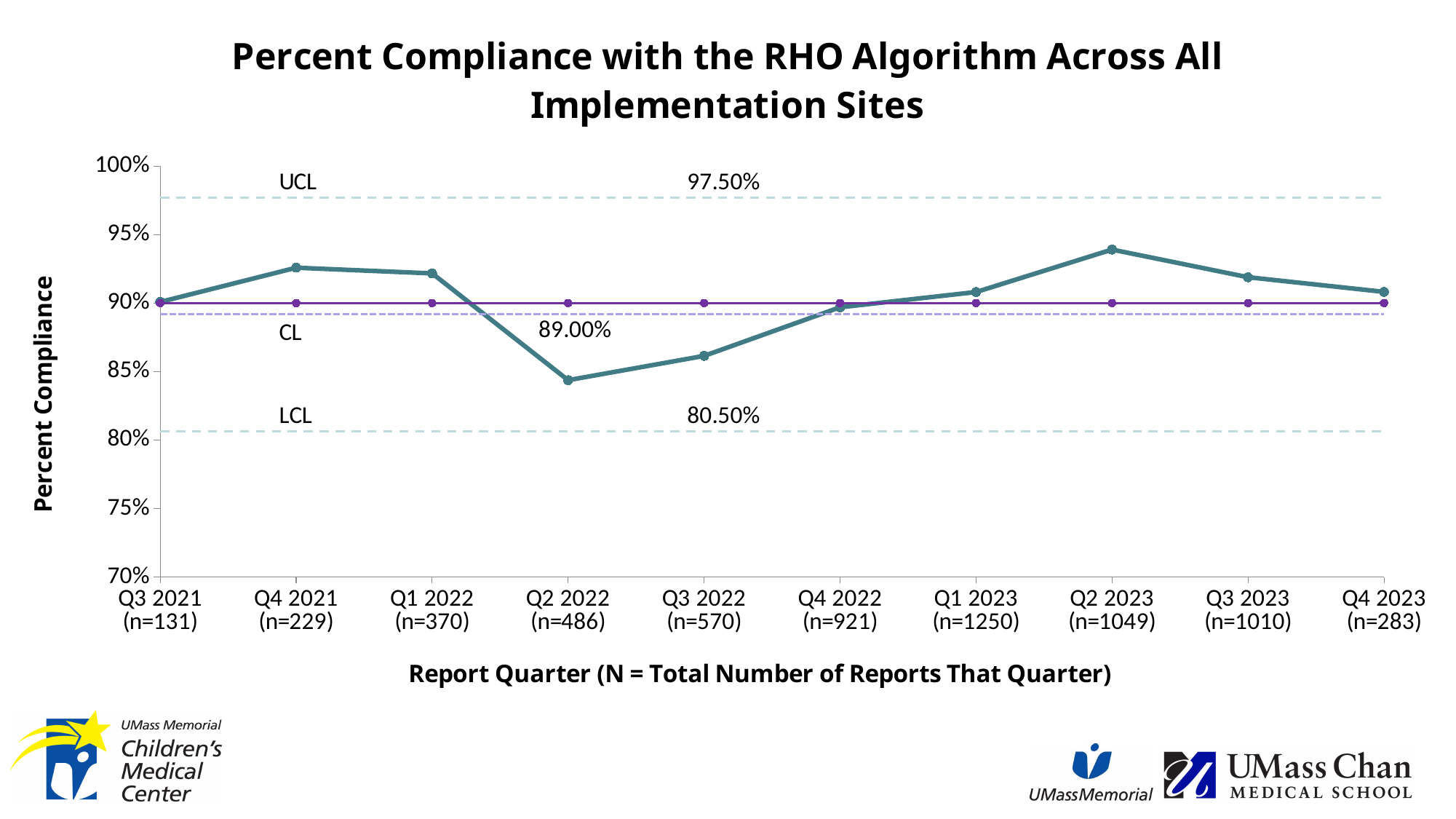
What is the value of the CL (center line) shown on the chart? 89.00% What is the value of the LCL (lower control limit) shown on the chart? 80.50% How many report quarters are plotted along the x axis? 10 What is the difference between the UCL and the LCL values printed on the chart? 17.00% Which report quarter has the highest percent compliance? Q2 2023 Which has the higher percent compliance, Q4 2021 or Q3 2022? Q4 2021 Is the percent compliance for Q2 2023 greater or less than 90%? greater Is the percent compliance for Q2 2022 greater or less than 85%? less Which report quarter has the lowest percent compliance? Q2 2022 How many reports (n) were there in Q1 2023 according to the x-axis label? 1250 What is the value of the UCL (upper control limit) shown on the chart? 97.50% What kind of chart is shown on the slide? line chart